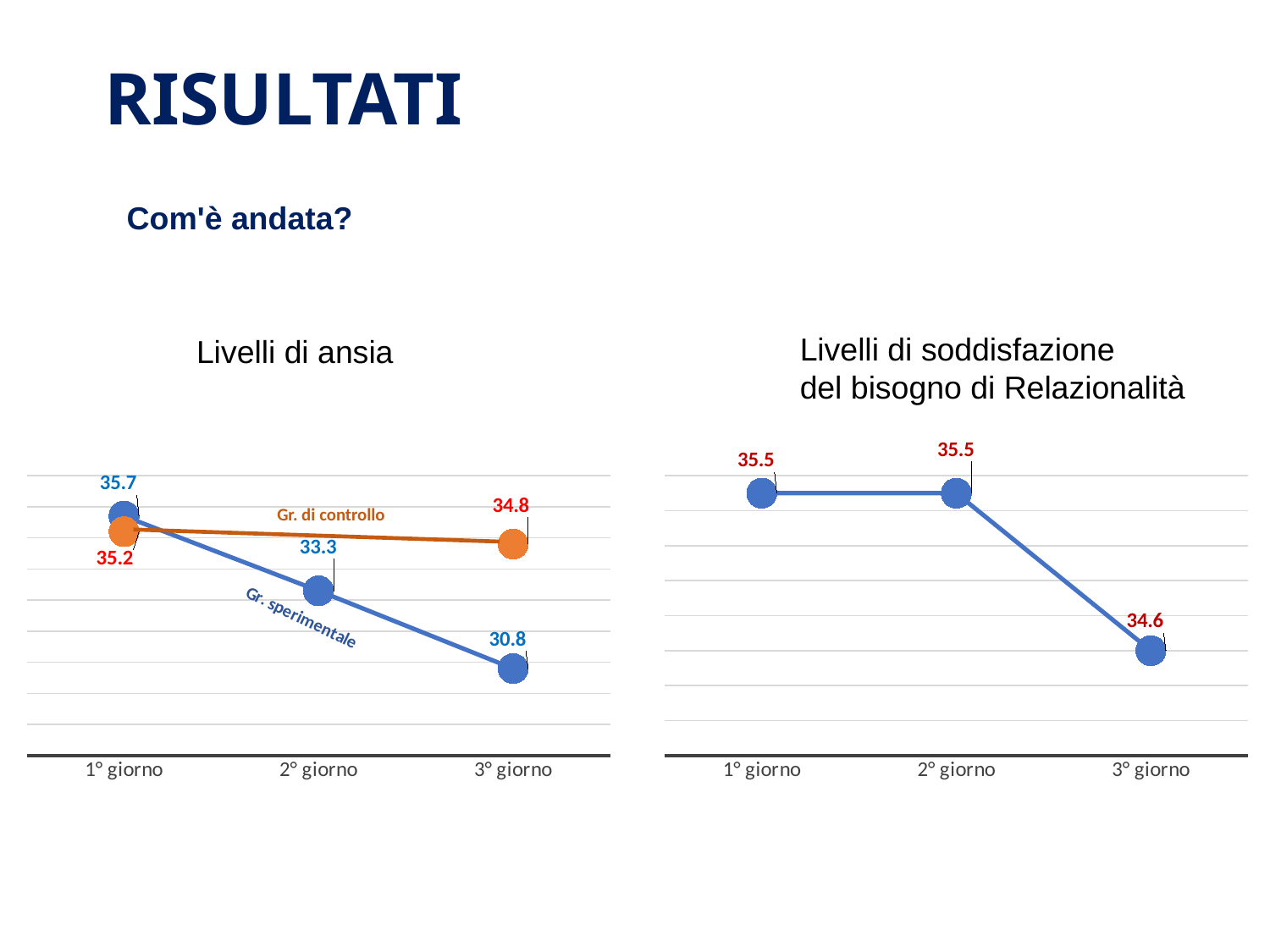
In the 'Livelli di ansia' chart, how many series are plotted? 2 In the 'Livelli di ansia' chart, what is the value for Gr. di controllo on 1° giorno? 35.2 In the 'Livelli di ansia' chart, what is the difference between the Gr. di controllo and Gr. sperimentale values on 3° giorno? 4.0 What kind of chart is the 'Livelli di soddisfazione del bisogno di Relazionalità' chart? line chart In the 'Livelli di ansia' chart, what is the value for Gr. di controllo on 3° giorno? 34.8 In the 'Livelli di ansia' chart, what is the value for Gr. sperimentale on 2° giorno? 33.3 In the 'Livelli di ansia' chart, which group has the higher value on 3° giorno? Gr. di controllo In the 'Livelli di ansia' chart, does the Gr. sperimentale line rise or fall from 1° giorno to 3° giorno? fall In the 'Livelli di soddisfazione del bisogno di Relazionalità' chart, on which day is the value lowest? 3° giorno In the 'Livelli di ansia' chart, what is the value for Gr. sperimentale on 1° giorno? 35.7 In the 'Livelli di soddisfazione del bisogno di Relazionalità' chart, what is the value on 3° giorno? 34.6 In the 'Livelli di soddisfazione del bisogno di Relazionalità' chart, what is the value on 1° giorno? 35.5